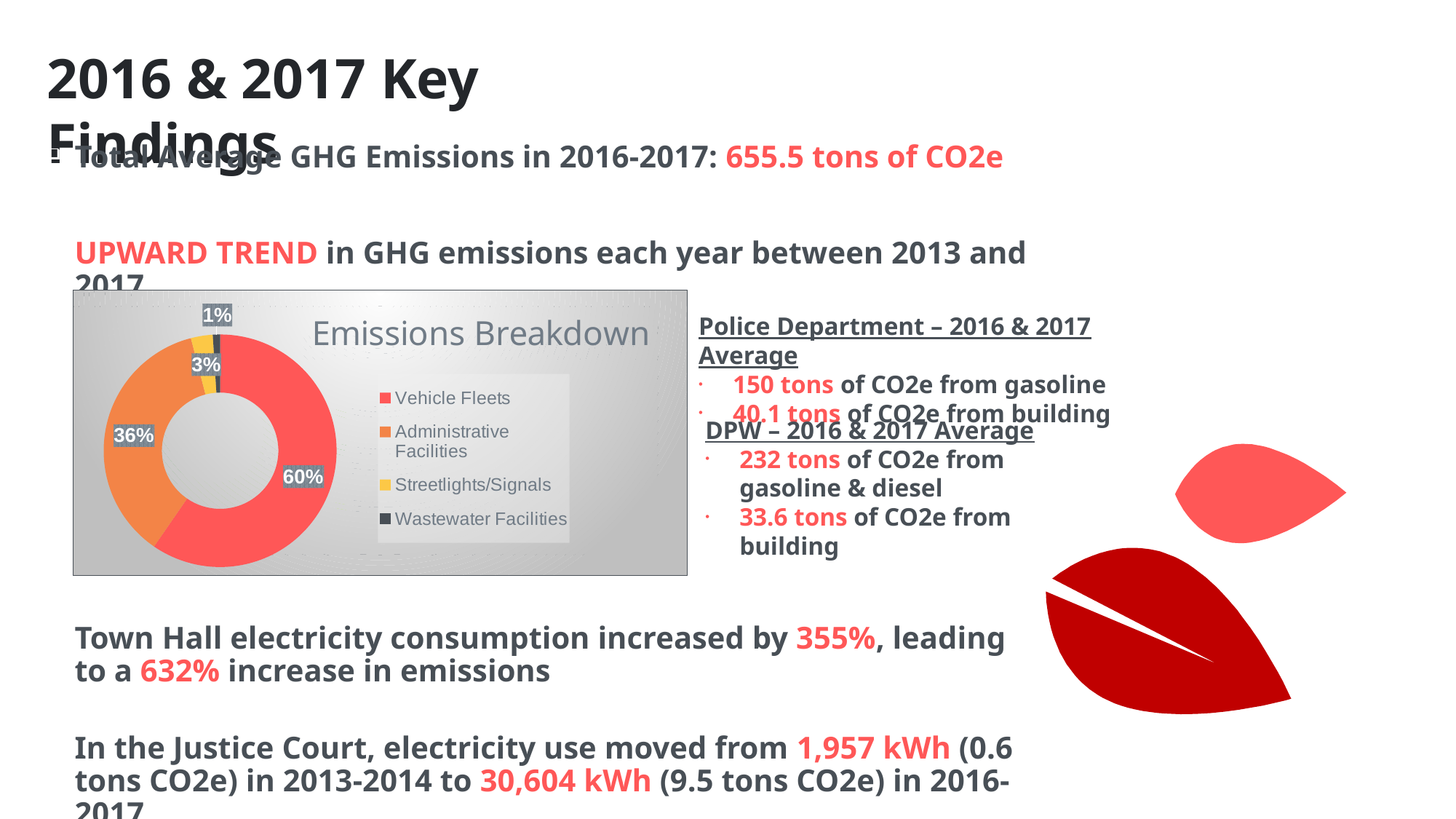
Which category has the smallest share in the Emissions Breakdown chart? Wastewater Facilities In the Emissions Breakdown chart, what share of emissions comes from Wastewater Facilities? 1% In the Emissions Breakdown chart, what share of emissions comes from Streetlights/Signals? 3% In the Emissions Breakdown chart, which is larger: Streetlights/Signals or Wastewater Facilities? Streetlights/Signals In the Emissions Breakdown chart, what share of emissions comes from Vehicle Fleets? 60% In the Emissions Breakdown chart, what is the difference in percentage points between Vehicle Fleets and Administrative Facilities? 24 percentage points What is the title of the chart on the slide? Emissions Breakdown In the Emissions Breakdown chart, what colour represents Administrative Facilities? Orange What kind of chart is the Emissions Breakdown chart? Doughnut chart How many categories does the legend of the Emissions Breakdown chart list? 4 Which category has the largest share in the Emissions Breakdown chart? Vehicle Fleets